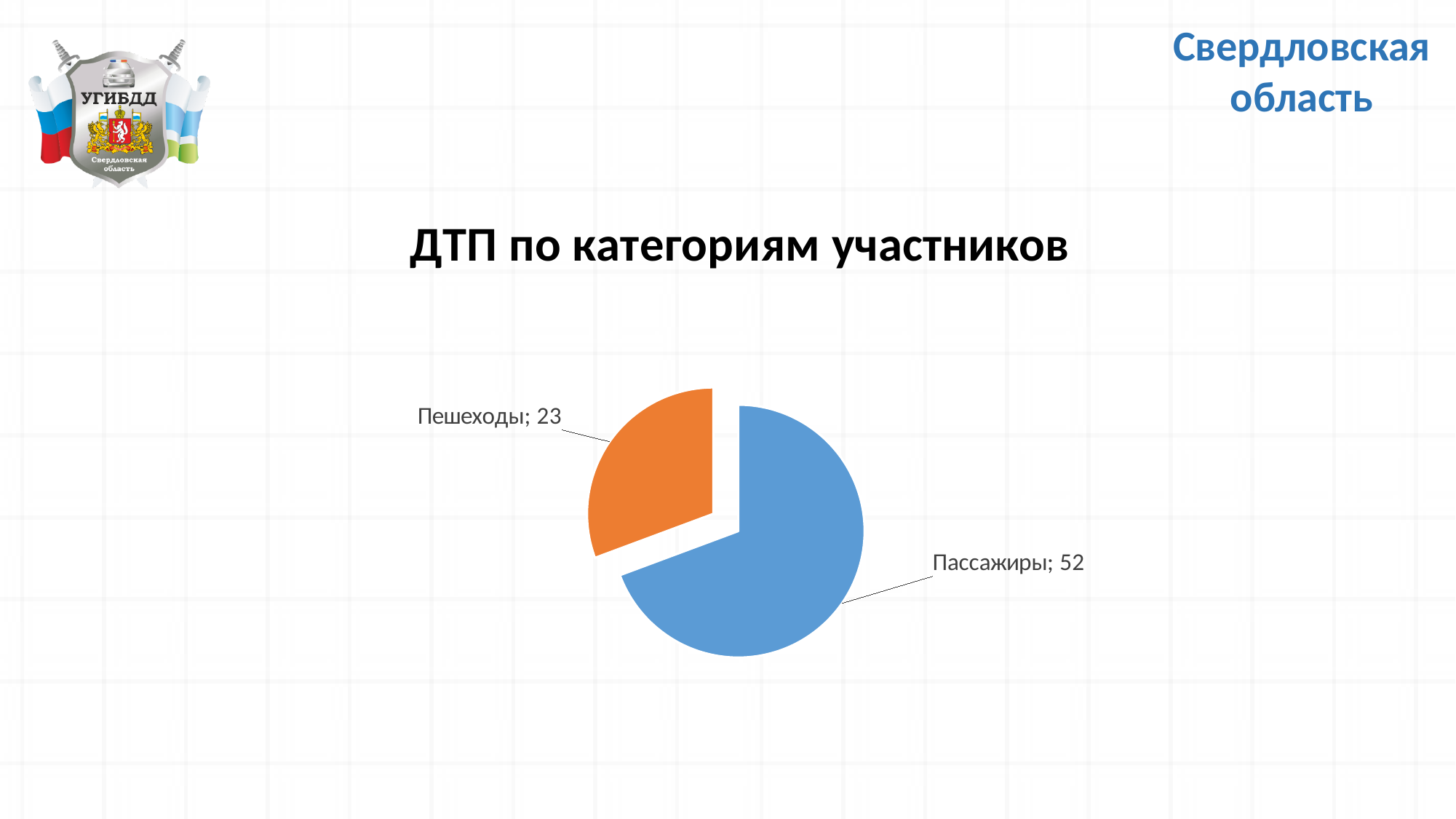
What is the difference between the values for Пассажиры and Пешеходы? 29 What kind of chart is shown on the slide? Pie chart What is the value for Пешеходы in the pie chart? 23 What is the value for Пассажиры in the pie chart? 52 Which category has the smallest slice in the pie chart? Пешеходы Which is larger, the value for Пешеходы or the value for Пассажиры? Пассажиры How many categories are shown in the pie chart? 2 What colour is the slice for Пешеходы? Orange What is the total of the two values shown in the pie chart? 75 Which category has the largest slice in the pie chart? Пассажиры What is the title of the chart? ДТП по категориям участников